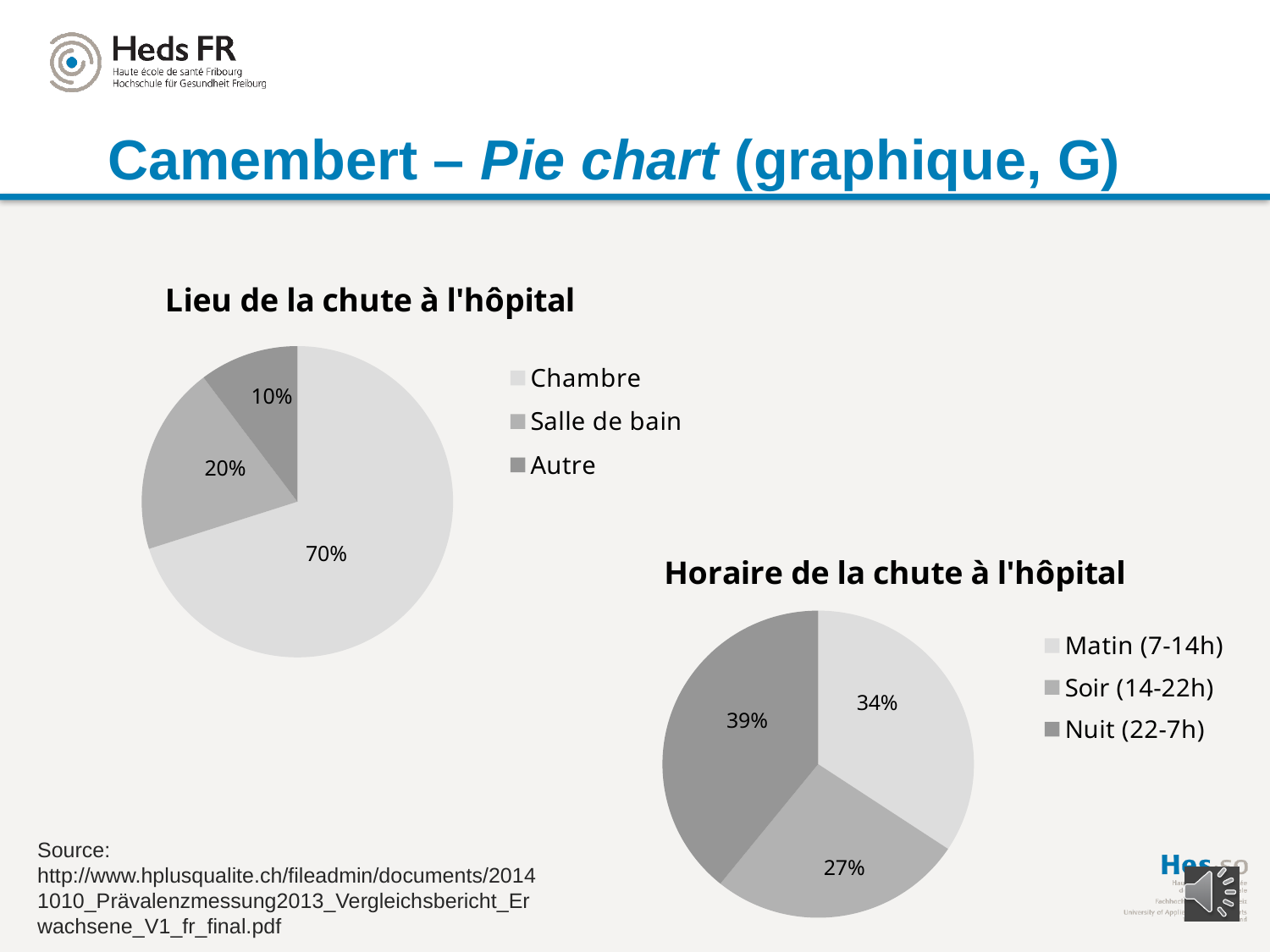
In the chart titled "Horaire de la chute à l'hôpital", what is the difference in percentage points between Nuit (22-7h) and Soir (14-22h)? 12 In the chart titled "Horaire de la chute à l'hôpital", which time period has the largest share of falls? Nuit (22-7h) In the chart titled "Horaire de la chute à l'hôpital", what percentage is shown for Soir (14-22h)? 27% In the chart titled "Horaire de la chute à l'hôpital", which is larger, Matin (7-14h) or Soir (14-22h)? Matin (7-14h) In the chart titled "Lieu de la chute à l'hôpital", which category has the smallest slice? Autre How many charts are shown on the slide? 2 In the chart titled "Lieu de la chute à l'hôpital", how many categories does the legend list? 3 In the chart titled "Lieu de la chute à l'hôpital", what is the difference in percentage points between Chambre and Salle de bain? 50 In the chart titled "Lieu de la chute à l'hôpital", what share of falls occurred in the Chambre? 70% What type of chart is used for "Horaire de la chute à l'hôpital"? Pie chart In the chart titled "Horaire de la chute à l'hôpital", what percentage is shown for Nuit (22-7h)? 39% In the chart titled "Lieu de la chute à l'hôpital", what percentage is shown for Salle de bain? 20%